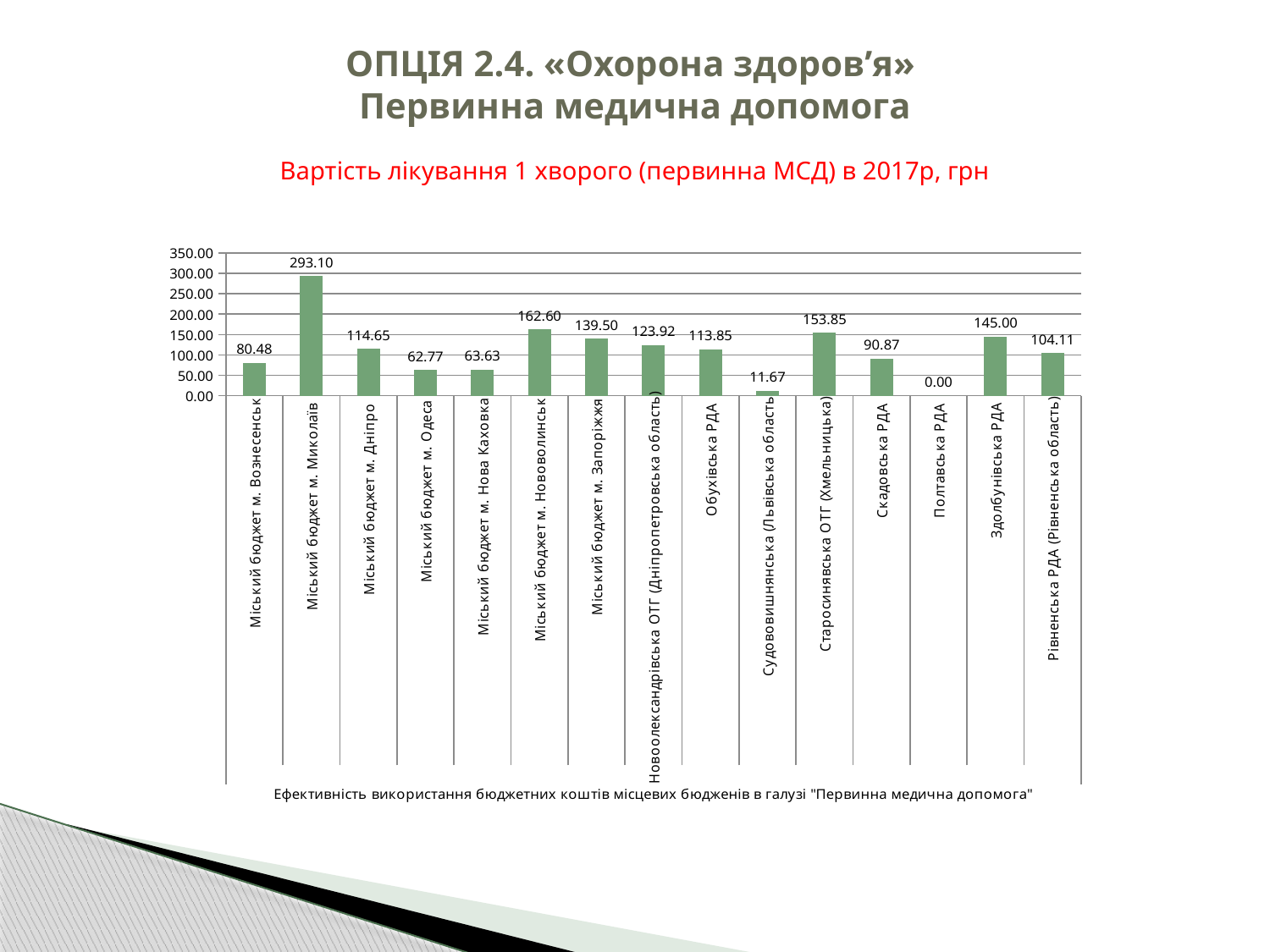
What is the value for Здолбунівська РДА? 145.00 Which category has the lowest value? Полтавська РДА What is the difference between the values for Міський бюджет м. Нововолинськ and Міський бюджет м. Запоріжжя? 23.10 Which is larger, the value for Міський бюджет м. Одеса or the value for Скадовська РДА? Скадовська РДА What is the value for Судововишнянська (Львівська область)? 11.67 What is the value for Міський бюджет м. Миколаїв? 293.10 Is the value for Скадовська РДА greater or less than 100.00? less What is the difference between the values for Міський бюджет м. Миколаїв and Міський бюджет м. Вознесенськ? 212.62 How many categories are shown in the chart? 15 Which category has the highest value? Міський бюджет м. Миколаїв What is the value for Старосинявська ОТГ (Хмельницька)? 153.85 What kind of chart is shown on the slide? bar chart